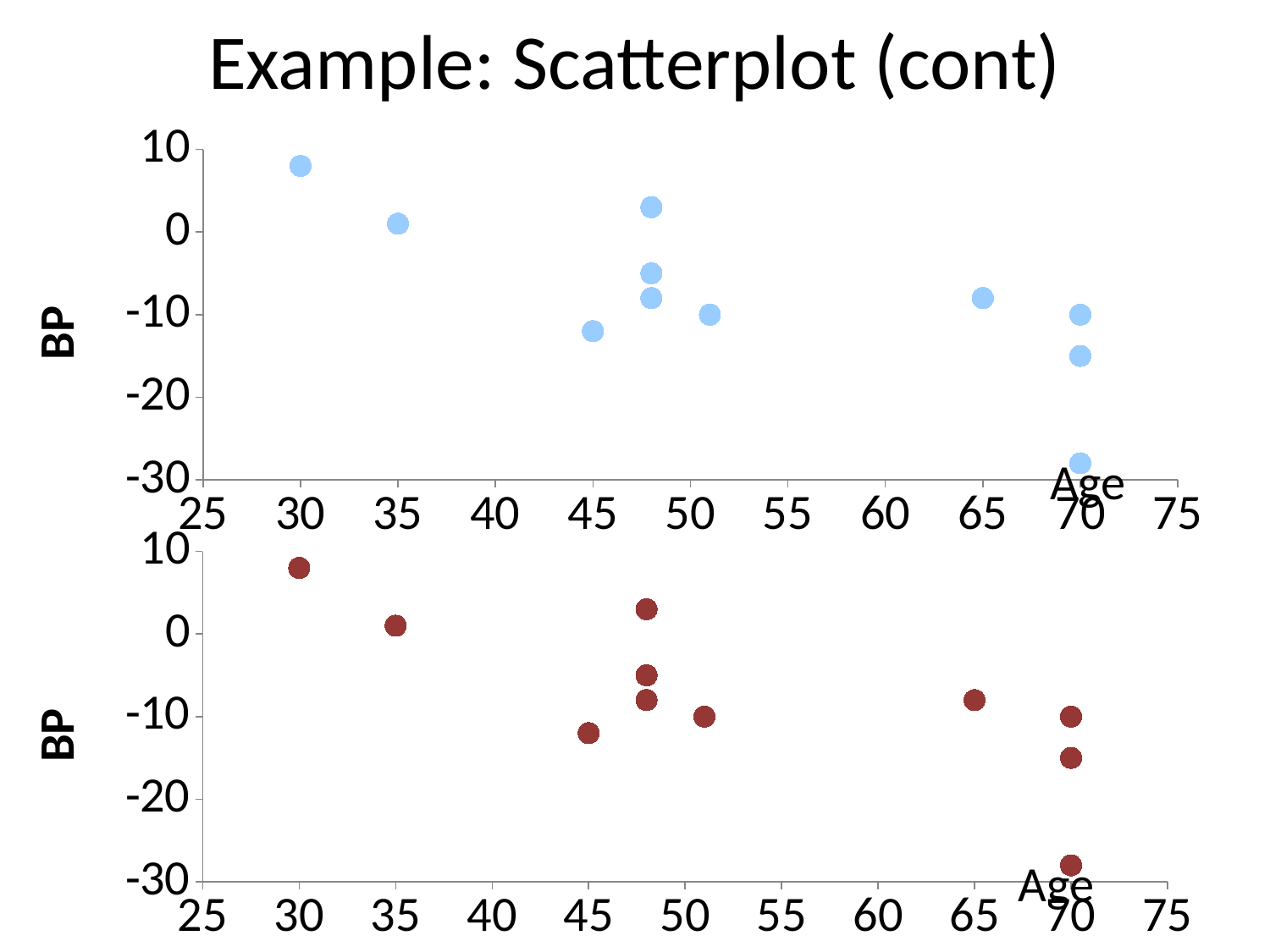
What colour are the points in the bottom chart? Dark red In the top chart, do BP values generally rise or fall as age increases? Fall In the top chart, is the BP value for age 30 greater or less than 0? greater In the bottom chart, how many data points are plotted? 11 In the bottom chart, is the BP value for age 45 greater or less than -10? less In the bottom chart, which has the higher BP value: the point at age 30 or the point at age 35? Age 30 In the top chart, how many data points are plotted? 11 What kind of chart is the top chart on the slide? Scatter plot In the top chart, at which age is the highest BP value plotted? 30 What is the label of the x axis in the top chart? Age In the top chart, is the lowest BP value at age 70 greater or less than -20? less In the bottom chart, at which age is the lowest BP value plotted? 70